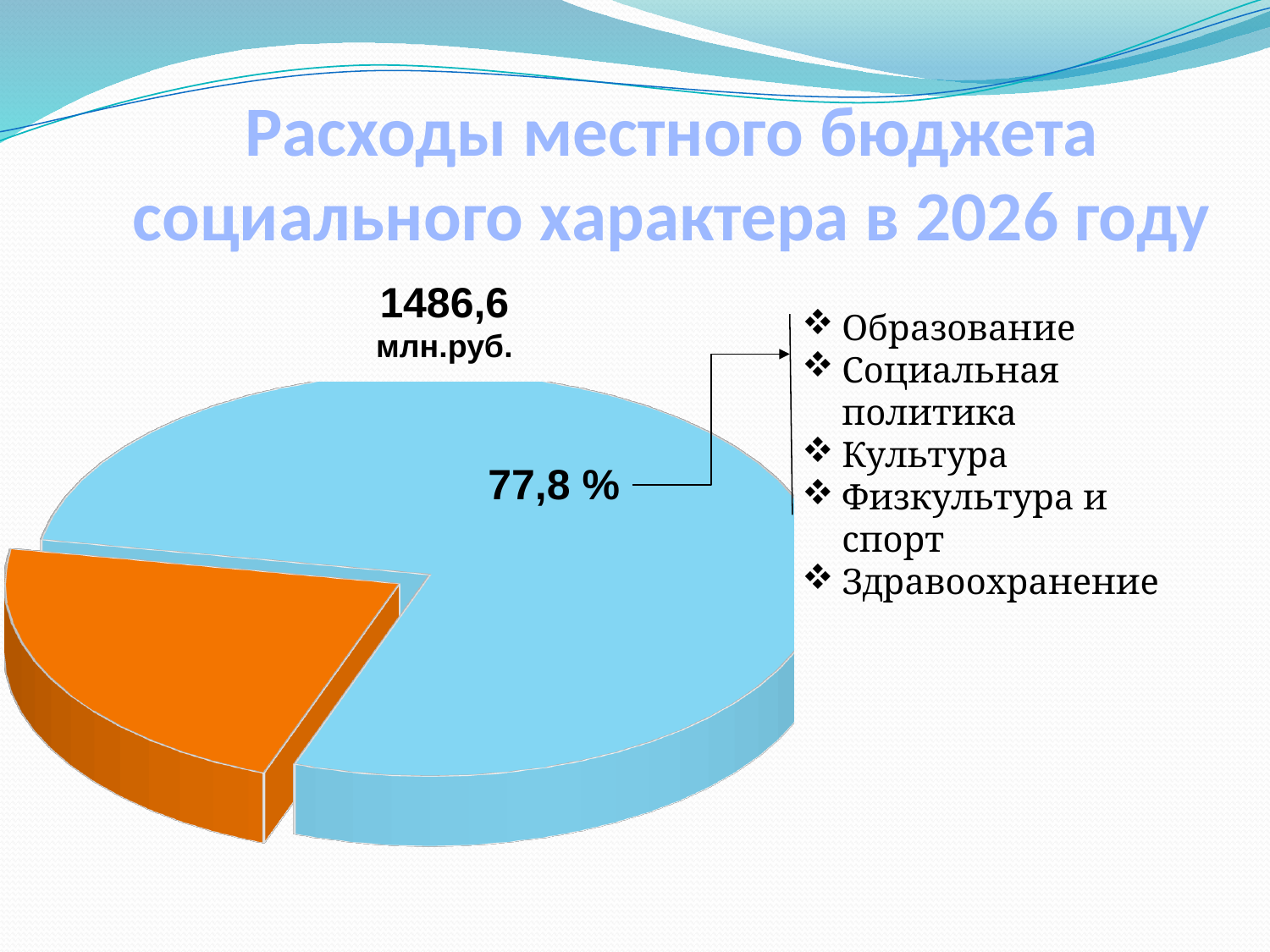
Is the share of the blue slice greater or less than 50%? greater What is the title of the slide with the pie chart? Расходы местного бюджета социального характера в 2026 году Which slice of the pie chart is the smallest? the orange slice How many slices does the pie chart have? 2 Which slice of the pie chart is the largest? the blue slice (77,8 %) What percentage is printed on the large blue slice of the pie chart? 77,8 % What total amount in million rubles is printed above the pie chart? 1486,6 млн.руб. What kind of chart is shown on the slide? pie chart Which slice of the pie chart is larger, the blue one or the orange one? the blue one